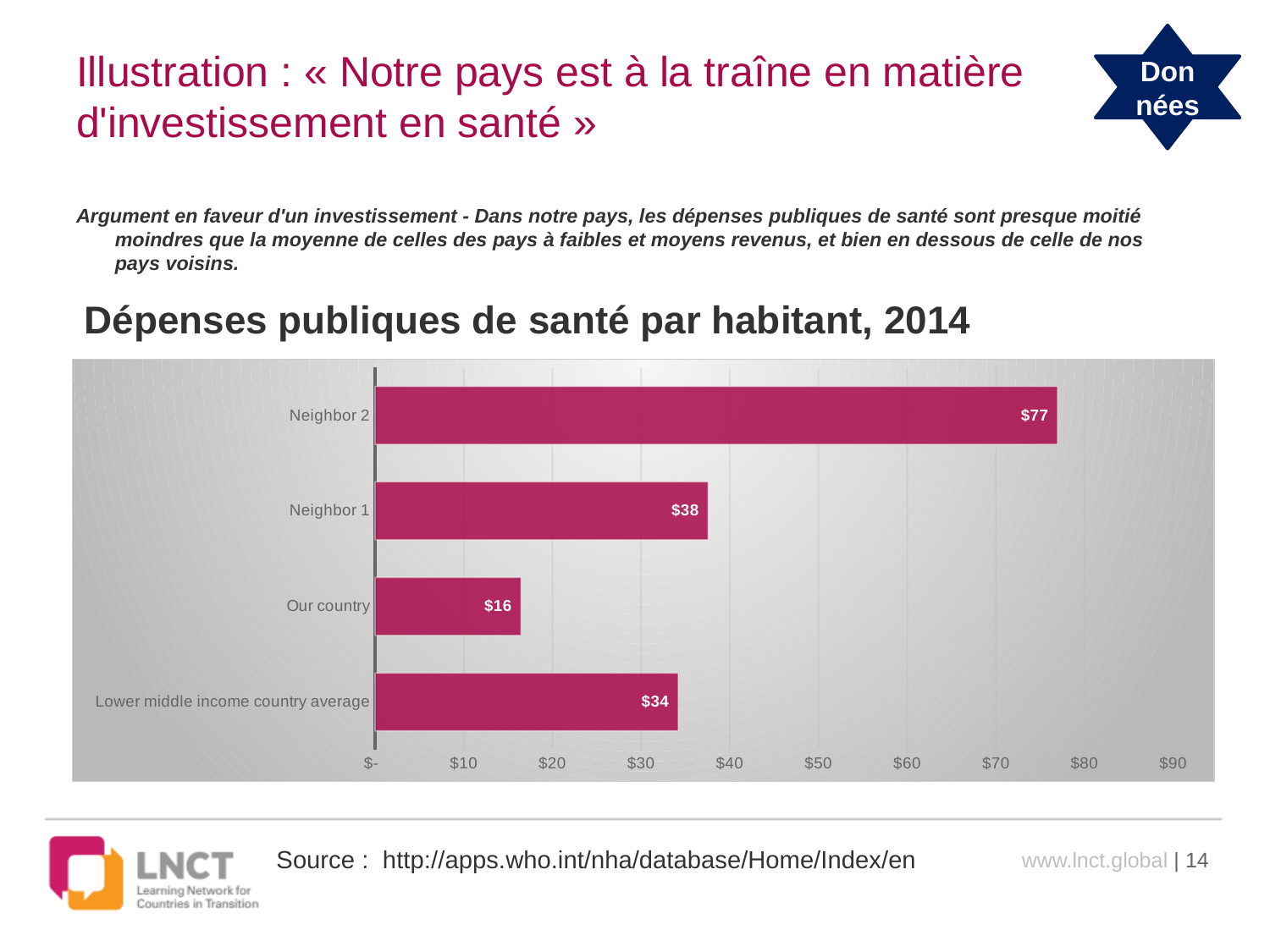
Which category has the highest value? Neighbor 2 What is the value for Neighbor 2? $77 Is the value for Neighbor 2 greater or less than $70? greater What is the value for Neighbor 1? $38 Which is larger, the value for Neighbor 1 or the value for Our country? Neighbor 1 What is the difference between the values for Neighbor 2 and Our country? $61 How many categories are shown in the chart? 4 What is the difference between the values for Neighbor 1 and Lower middle income country average? $4 What is the value for Our country? $16 What is the value for Lower middle income country average? $34 What kind of chart is shown on the slide? Bar chart Which category has the lowest value? Our country